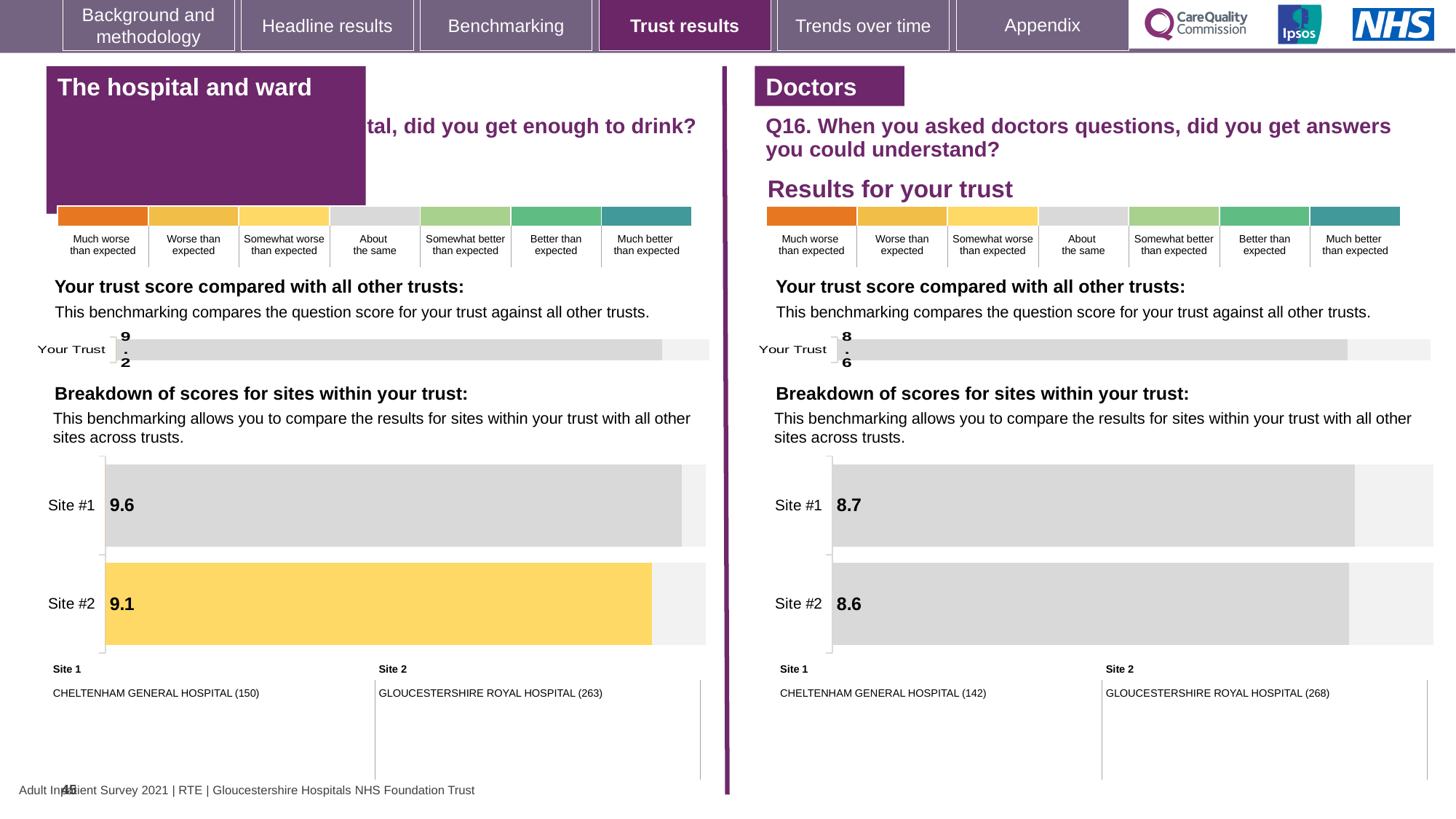
In the right-hand site breakdown chart (Doctors, Q16), what is the difference between the Site #1 and Site #2 scores? 0.1 On the right-hand slide section (Doctors, Q16), what is the 'Your Trust' score in the trust score comparison chart? 8.6 On the left-hand slide section (The hospital and ward), what is the 'Your Trust' score in the trust score comparison chart? 9.2 On the left-hand slide section (The hospital and ward), what is the score shown for Site #2 in the breakdown of scores for sites chart? 9.1 In the left-hand site breakdown chart (The hospital and ward), which site has the higher score? Site #1 On the right-hand slide section (Doctors, Q16), what is the score shown for Site #1 in the breakdown of scores for sites chart? 8.7 On the right-hand slide section (Doctors, Q16), what is the score shown for Site #2 in the breakdown of scores for sites chart? 8.6 In the left-hand site breakdown chart (The hospital and ward), what is the difference between the Site #1 and Site #2 scores? 0.5 In the left-hand site breakdown chart (The hospital and ward), what colour is the Site #2 bar? Yellow How many sites are shown in the left-hand site breakdown chart (The hospital and ward)? 2 On the left-hand slide section (The hospital and ward), what is the score shown for Site #1 in the breakdown of scores for sites chart? 9.6 What type of chart is used for the breakdown of scores for sites on the right-hand section (Doctors, Q16)? Bar chart